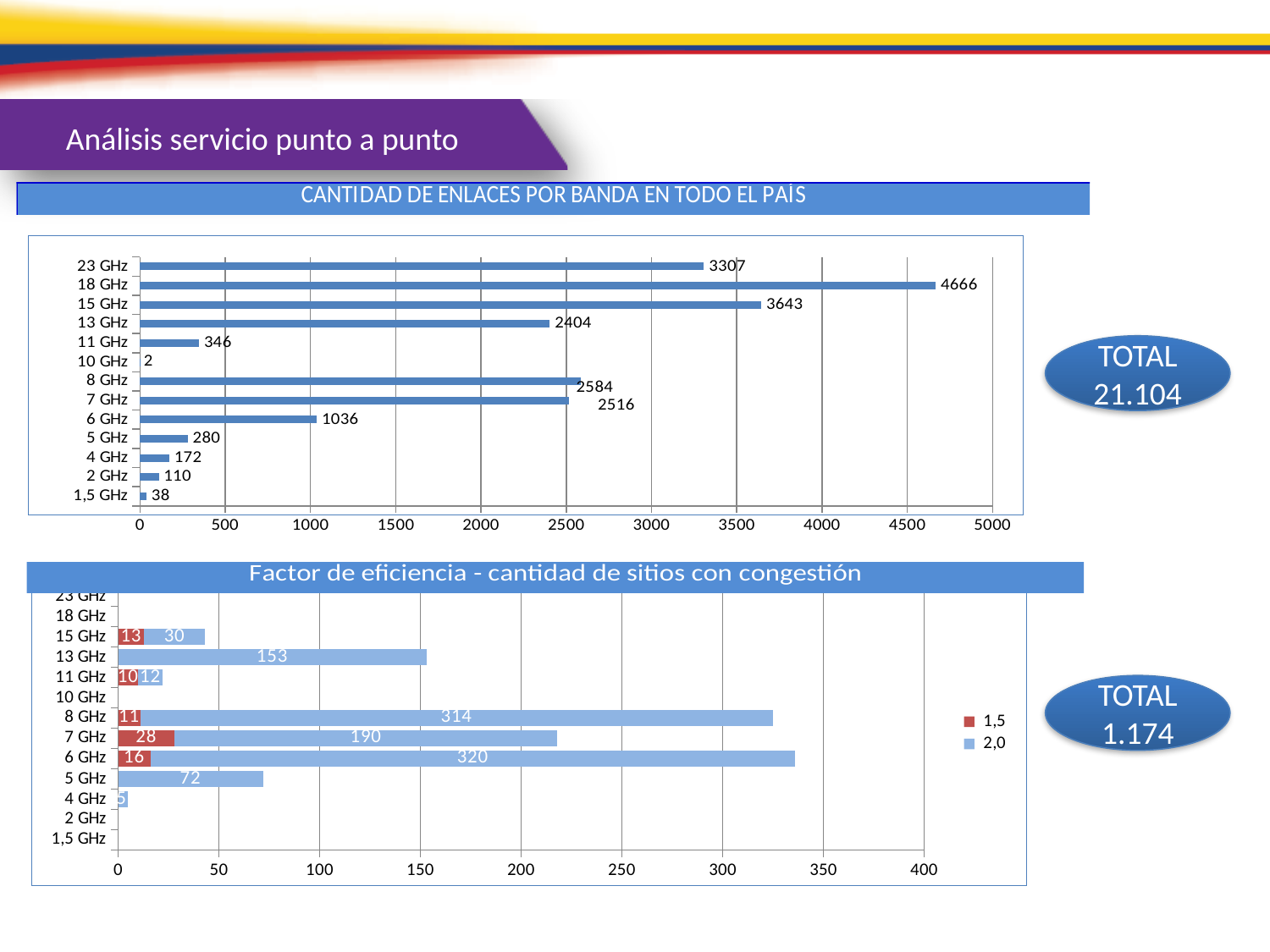
In the top chart (CANTIDAD DE ENLACES POR BANDA EN TODO EL PAÍS), which is larger, the value for 8 GHz or 7 GHz? 8 GHz What kind of chart is the top chart (CANTIDAD DE ENLACES POR BANDA EN TODO EL PAÍS)? Bar chart In the bottom chart (Factor de eficiencia - cantidad de sitios con congestión), is the total bar for 13 GHz greater or less than 100? greater In the top chart (CANTIDAD DE ENLACES POR BANDA EN TODO EL PAÍS), which band has the lowest value? 10 GHz In the bottom chart (Factor de eficiencia - cantidad de sitios con congestión), how many series does the legend list? 2 In the top chart (CANTIDAD DE ENLACES POR BANDA EN TODO EL PAÍS), which band has the highest value? 18 GHz In the top chart (CANTIDAD DE ENLACES POR BANDA EN TODO EL PAÍS), what is the value for 18 GHz? 4666 In the bottom chart (Factor de eficiencia - cantidad de sitios con congestión), what is the value of the 2,0 series for 6 GHz? 320 In the top chart (CANTIDAD DE ENLACES POR BANDA EN TODO EL PAÍS), how many bands are shown? 13 In the bottom chart (Factor de eficiencia - cantidad de sitios con congestión), what is the value of the 1,5 series for 7 GHz? 28 In the bottom chart (Factor de eficiencia - cantidad de sitios con congestión), what is the total of the stacked bar for 8 GHz? 325 In the top chart (CANTIDAD DE ENLACES POR BANDA EN TODO EL PAÍS), what is the difference between the values for 15 GHz and 23 GHz? 336